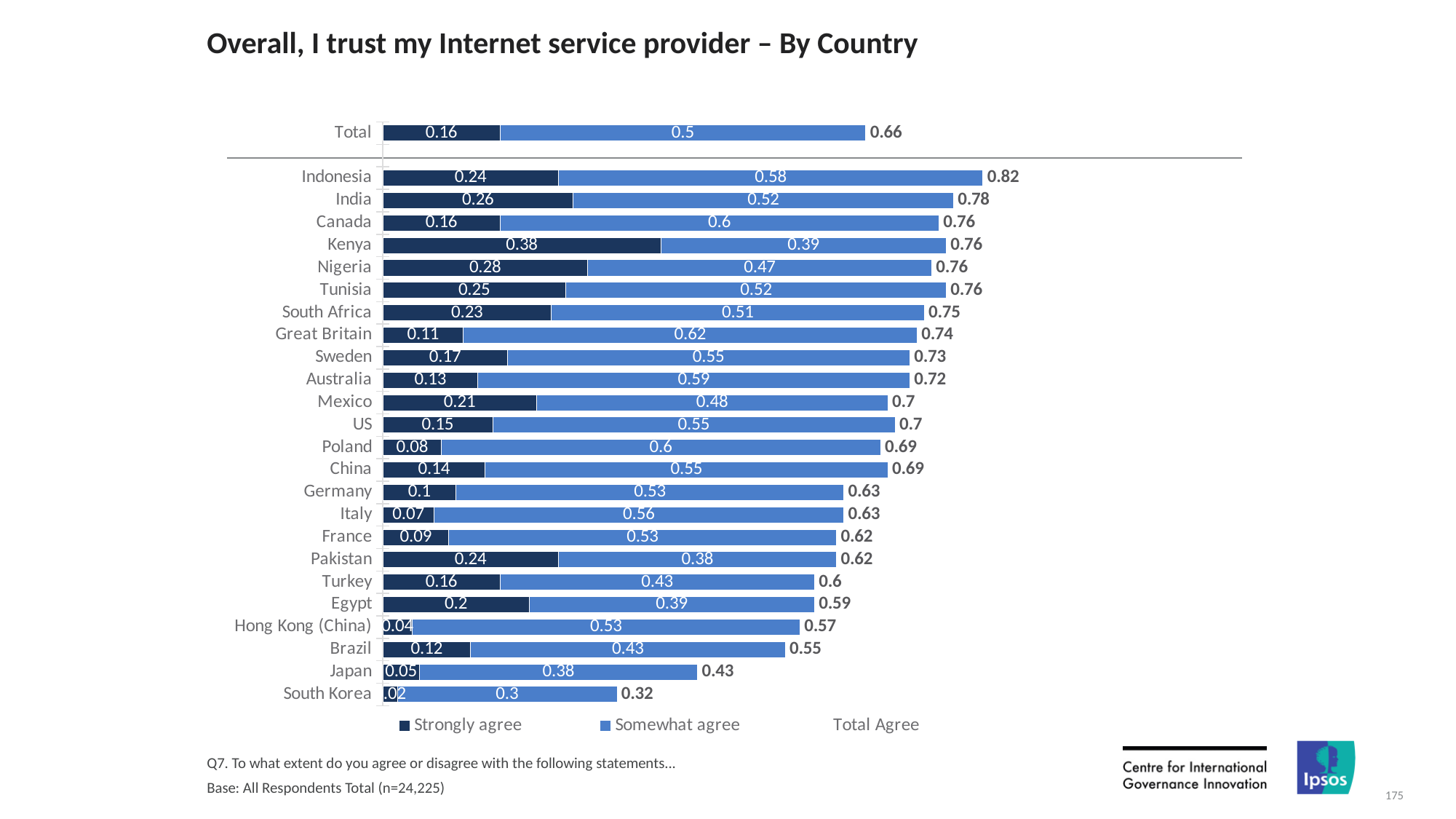
What kind of chart is shown on the slide? Stacked bar chart What is the Total Agree value for the overall Total bar? 0.66 What is the Total Agree value for Indonesia? 0.82 What is the 'Somewhat agree' value for Great Britain? 0.62 What is the difference between the Total Agree values for India and Brazil? 0.23 What is the 'Strongly agree' value for Kenya? 0.38 Which has a larger 'Somewhat agree' value, Canada or Nigeria? Canada What is the total of the stacked bar for Japan? 0.43 Which country has the highest 'Strongly agree' value? Kenya How many countries are listed below the Total bar? 24 Which country has the lowest Total Agree value? South Korea How many entries does the legend list? 3